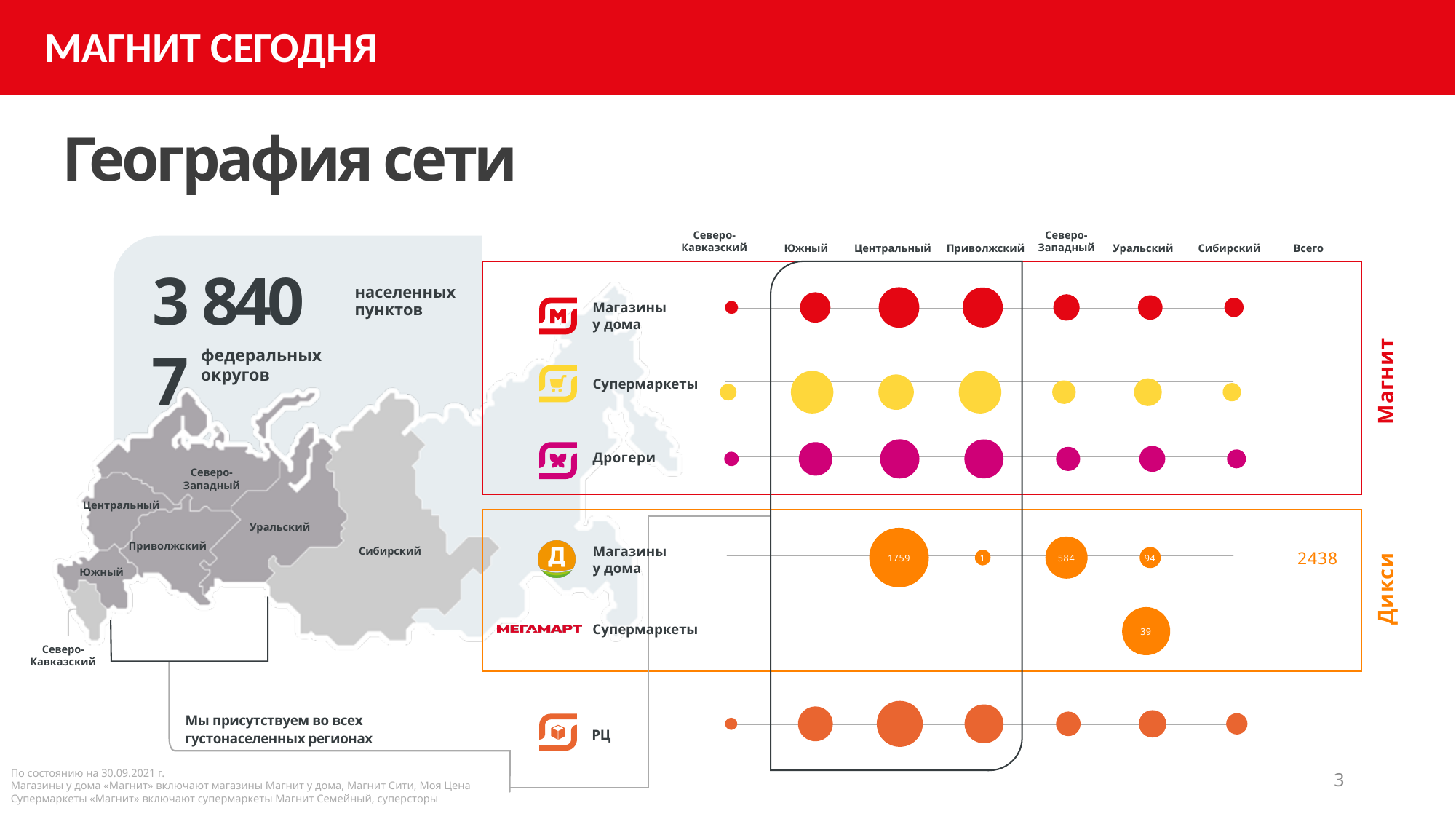
In the Дикси Магазины у дома row, what value is shown for the Уральский district? 94 In the Дикси Магазины у дома row, what is the difference between the Центральный and Северо-Западный values? 1175 In the Дикси Магазины у дома row, what value is shown for the Центральный district? 1759 What kind of chart is used to show the store distribution by district? Bubble chart In the Дикси Магазины у дома row, which is larger: the Северо-Западный value or the Уральский value? Северо-Западный How many federal districts are listed as columns across the top of the chart (excluding Всего)? 7 In the Дикси Магазины у дома row, what value is shown for the Приволжский district? 1 In the Мегамарт Супермаркеты row, what value is shown for the Уральский district? 39 Among the labelled districts in the Дикси Магазины у дома row, which district has the lowest value? Приволжский In the Дикси Магазины у дома row, what value is shown for the Северо-Западный district? 584 Among the labelled districts in the Дикси Магазины у дома row, which district has the highest value? Центральный What is the Всего (total) value shown for Дикси Магазины у дома? 2438